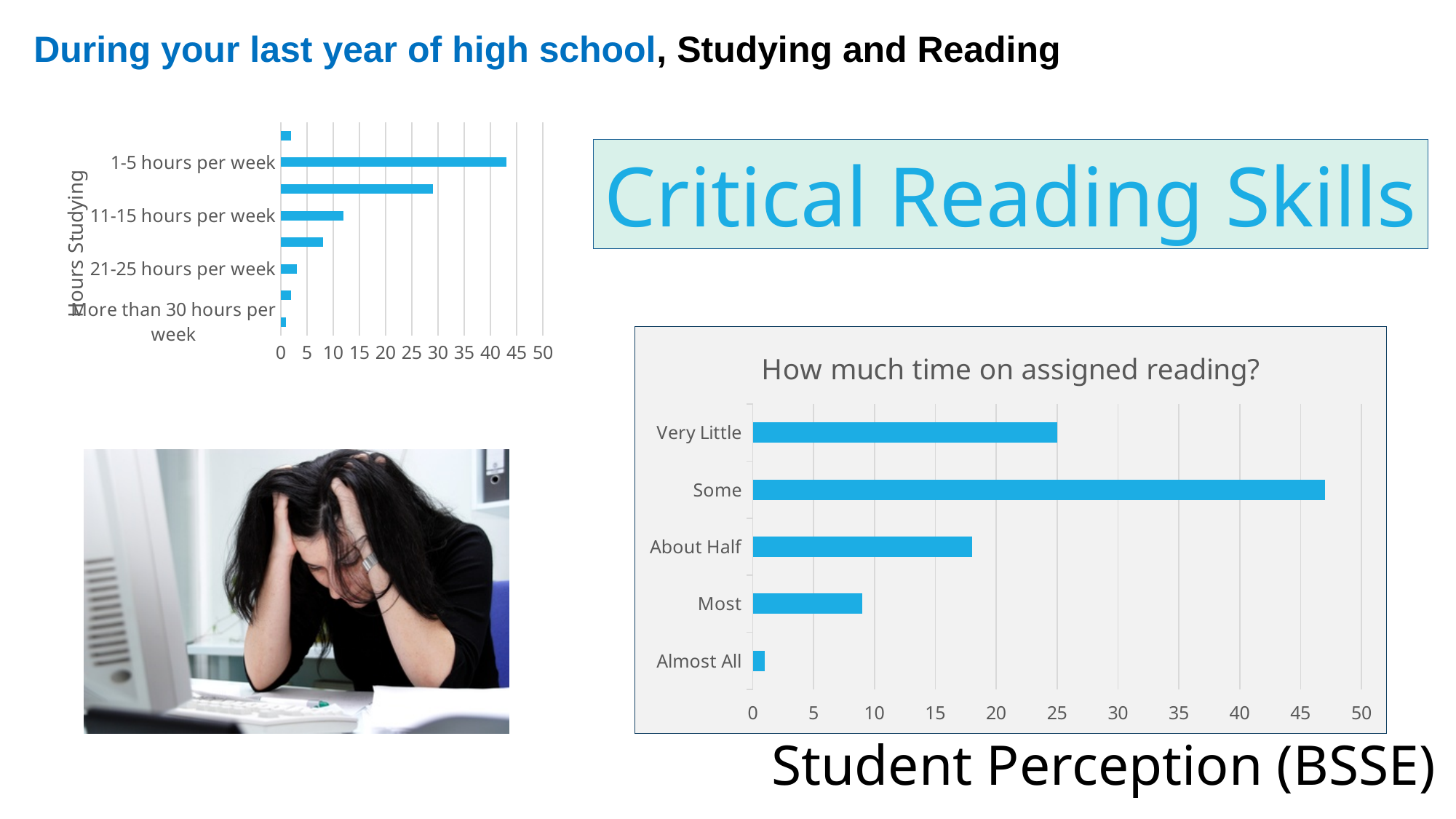
In the 'How much time on assigned reading?' chart, is the value for About Half greater or less than 20? less In the Hours Studying chart on the left, which labeled category has the highest value? 1-5 hours per week What kind of chart is the 'How much time on assigned reading?' chart? bar chart What is the vertical axis label of the chart on the left of the slide? Hours Studying In the Hours Studying chart on the left, which is larger, 11-15 hours per week or 21-25 hours per week? 11-15 hours per week In the 'How much time on assigned reading?' chart, which category has the lowest value? Almost All How many categories are shown in the 'How much time on assigned reading?' chart? 5 In the 'How much time on assigned reading?' chart, which category has the highest value? Some What is the title of the chart on the right of the slide? How much time on assigned reading? In the 'How much time on assigned reading?' chart, which is larger, Very Little or About Half? Very Little In the Hours Studying chart on the left, is the value for 1-5 hours per week greater or less than 40? greater In the 'How much time on assigned reading?' chart, is the value for Some greater or less than 45? greater